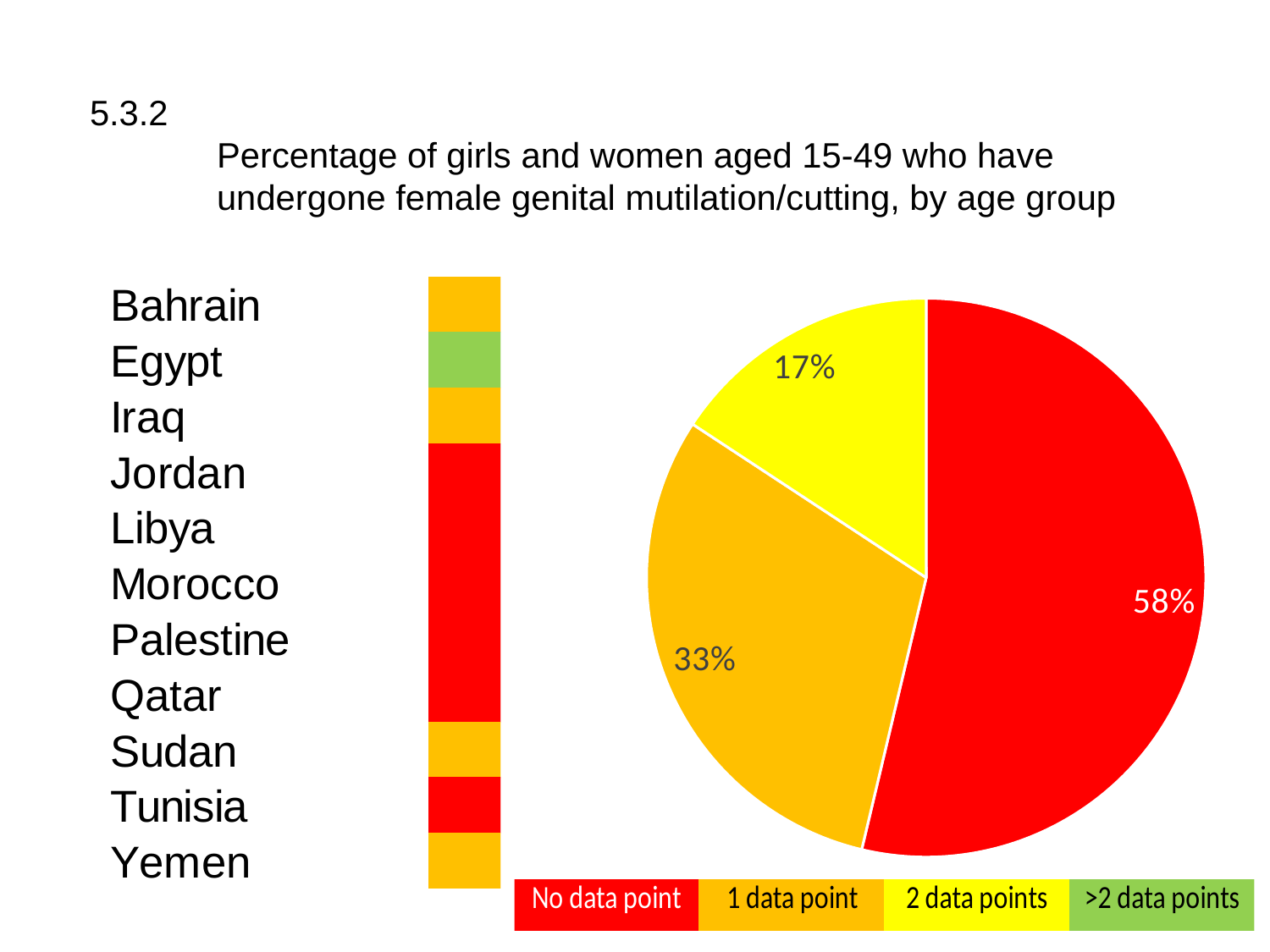
How many percentage points larger is the 'No data point' slice than the '1 data point' slice? 25 percentage points What percentage of the pie chart is labelled 'No data point'? 58% Is the 'No data point' share greater or less than 50%? greater What percentage of the pie chart corresponds to '2 data points'? 17% Which category has the smallest slice of the pie chart? 2 data points How many slices does the pie chart have? 3 What percentage of the pie chart corresponds to '1 data point'? 33% What is the difference in percentage points between the '1 data point' slice and the '2 data points' slice? 16 percentage points What colour is the 'No data point' slice in the pie chart? Red What kind of chart is shown on the slide? Pie chart Which slice is larger, '1 data point' or '2 data points'? 1 data point Which category has the largest slice of the pie chart? No data point